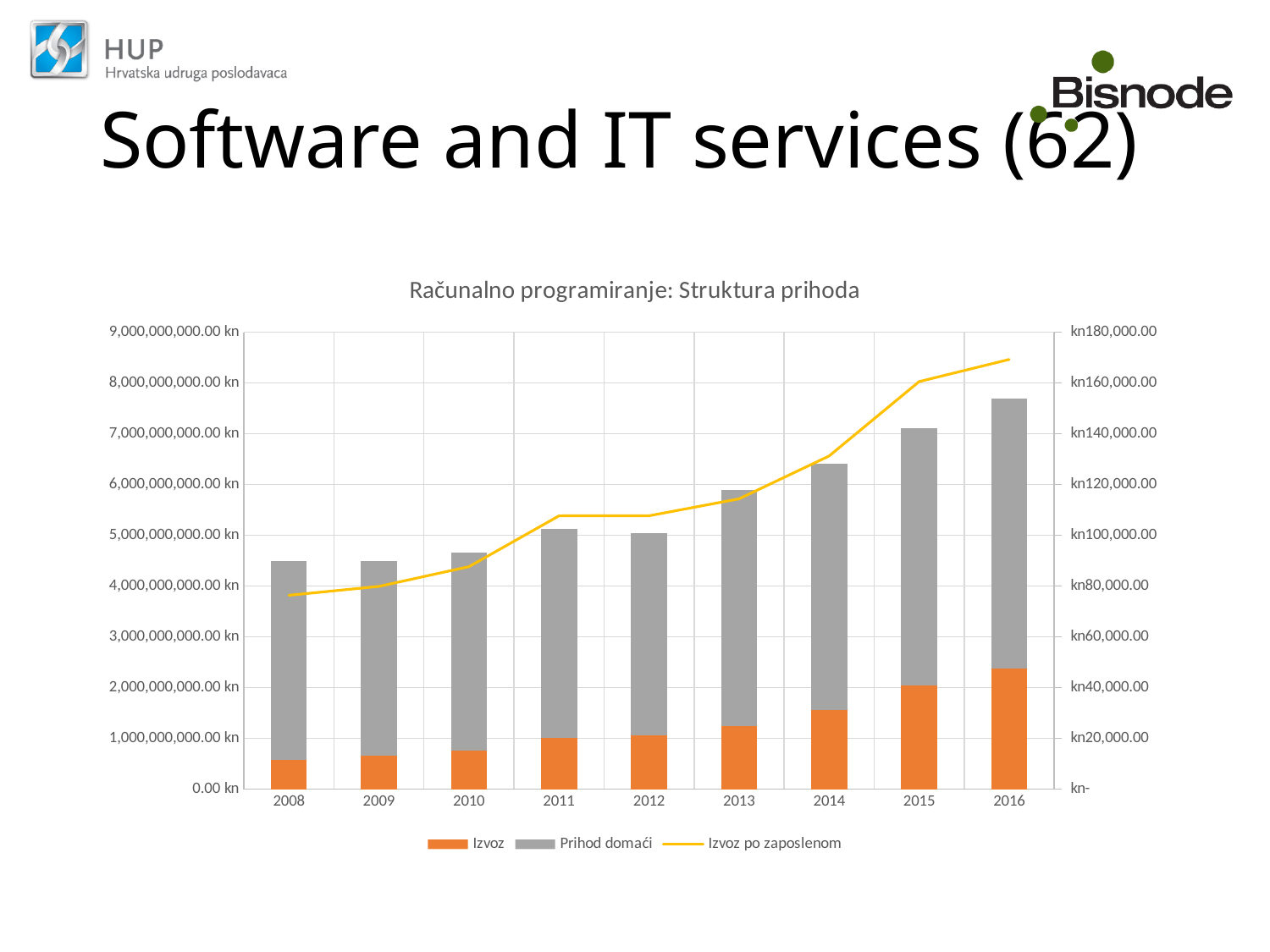
Is the Izvoz po zaposlenom value for 2015 greater or less than kn140,000.00? greater Which year has the tallest stacked bar (highest total revenue)? 2016 What kind of chart is shown on the slide? Stacked bar chart with a line Does the Izvoz po zaposlenom line rise or fall from 2008 to 2016? rise How many series does the legend list? 3 Which year has the highest Izvoz value? 2016 Is the total stacked bar for 2016 greater or less than 7,000,000,000.00 kn? greater How many years are shown on the x axis? 9 Which year has the larger total stacked bar, 2012 or 2015? 2015 What is the title of the chart? Računalno programiranje: Struktura prihoda Is the total stacked bar for 2008 greater or less than 5,000,000,000.00 kn? less